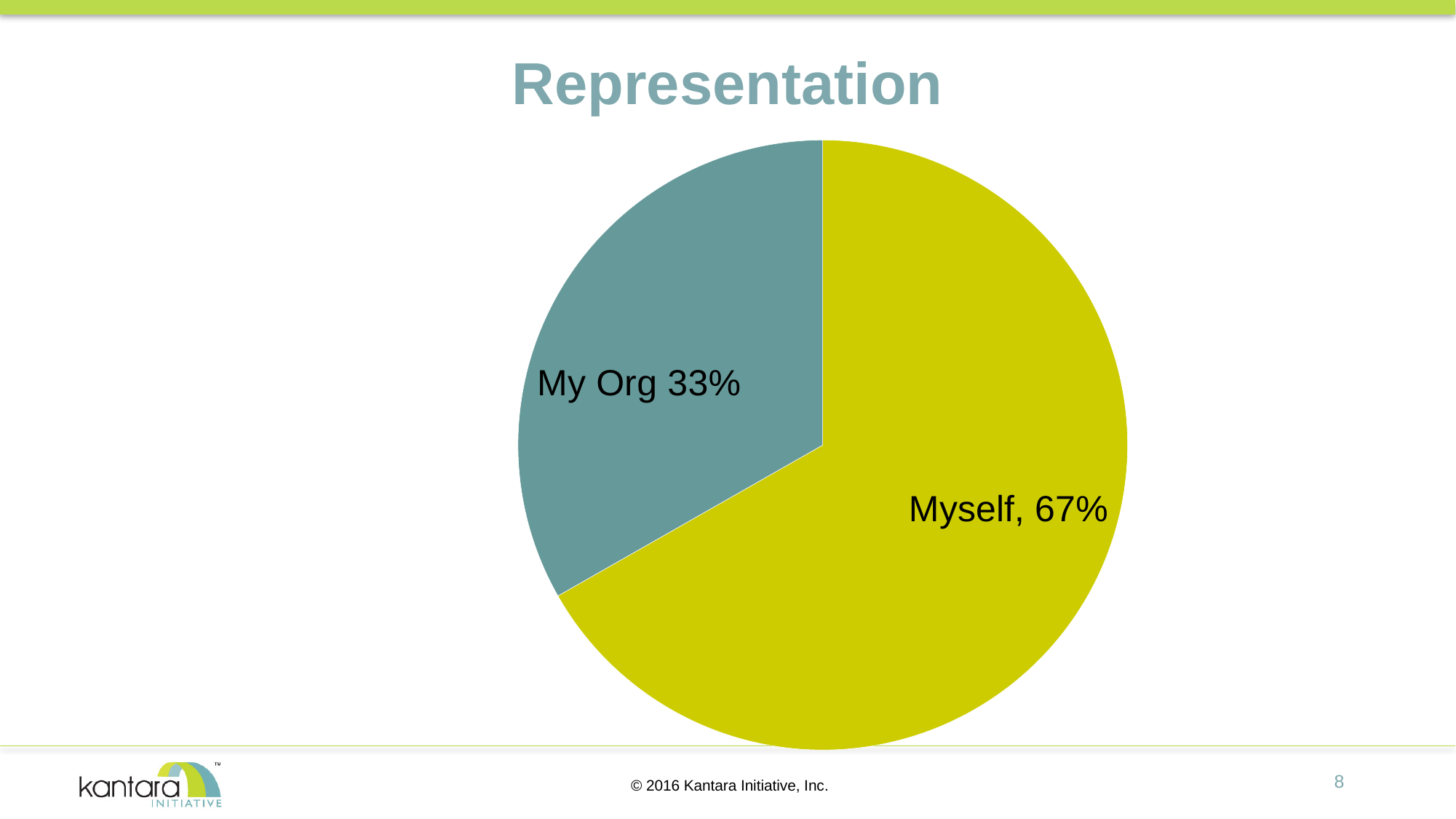
Which is larger, the Myself slice or the My Org slice? Myself How many slices does the pie chart have? 2 What share of the pie does the Myself slice represent? 67% Which slice is the largest? Myself What is the difference in percentage points between the Myself and My Org slices? 34 Which slice is the smallest? My Org What is the title of the chart? Representation What kind of chart is shown on the slide? pie chart What colour is the Myself slice? yellow-green What share of the pie does the My Org slice represent? 33%